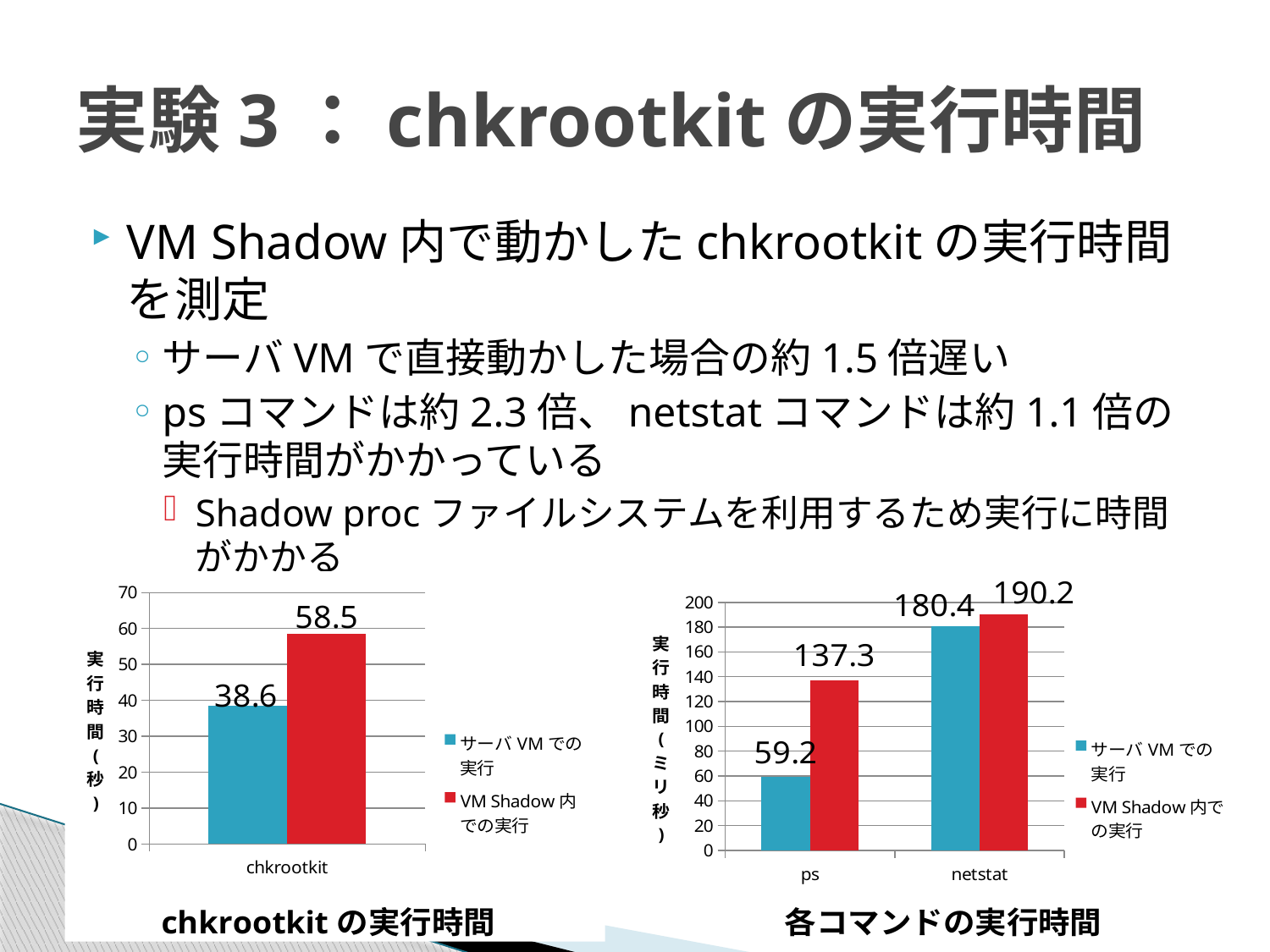
In the right chart (各コマンドの実行時間), what is the value for netstat under VM Shadow 内での実行? 190.2 In the right chart (各コマンドの実行時間), what is the difference between the two ps values? 78.1 In the right chart (各コマンドの実行時間), how many series does the legend list? 2 What kind of chart is the left chart (chkrootkit の実行時間)? Bar chart In the left chart (chkrootkit の実行時間), what is the difference between the VM Shadow 内での実行 value and the サーバ VM での実行 value? 19.9 In the left chart (chkrootkit の実行時間), which series has the larger value: サーバ VM での実行 or VM Shadow 内での実行? VM Shadow 内での実行 In the right chart (各コマンドの実行時間), which bar is the highest? netstat, VM Shadow 内での実行 (190.2) In the left chart (chkrootkit の実行時間), what is the value for VM Shadow 内での実行? 58.5 In the right chart (各コマンドの実行時間), what is the value for ps under サーバ VM での実行? 59.2 In the right chart (各コマンドの実行時間), what is the value for ps under VM Shadow 内での実行? 137.3 In the right chart (各コマンドの実行時間), what is the value for netstat under サーバ VM での実行? 180.4 In the left chart (chkrootkit の実行時間), what is the value for サーバ VM での実行? 38.6